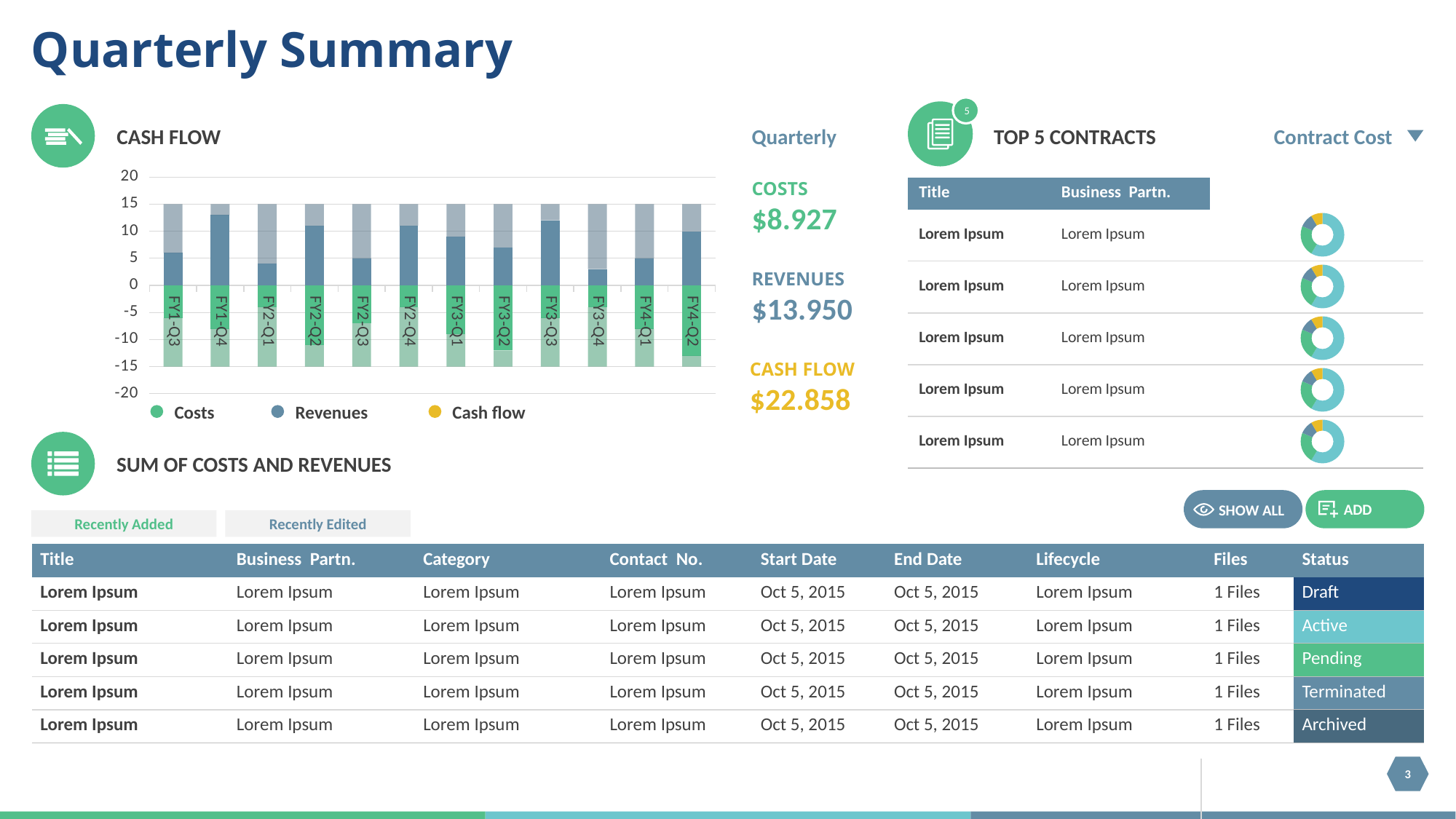
In the CASH FLOW chart, is the Revenues value for FY3-Q4 greater or less than 5? less How many quarters are shown on the x axis of the CASH FLOW chart? 12 What kind of chart is the CASH FLOW chart? bar chart In the CASH FLOW chart, is the Revenues value for FY3-Q3 greater or less than 10? greater Which series are listed in the legend of the CASH FLOW chart? Costs, Revenues, Cash flow What colour represents Costs in the CASH FLOW chart legend? green How many series does the legend of the CASH FLOW chart list? 3 In the CASH FLOW chart, which quarter has the larger Revenues value, FY1-Q4 or FY2-Q1? FY1-Q4 What is the first quarter label on the x axis of the CASH FLOW chart? FY1-Q3 In the CASH FLOW chart, which quarter has the larger Revenues value, FY3-Q3 or FY3-Q4? FY3-Q3 In the CASH FLOW chart, is the Revenues value for FY1-Q3 greater or less than 10? less